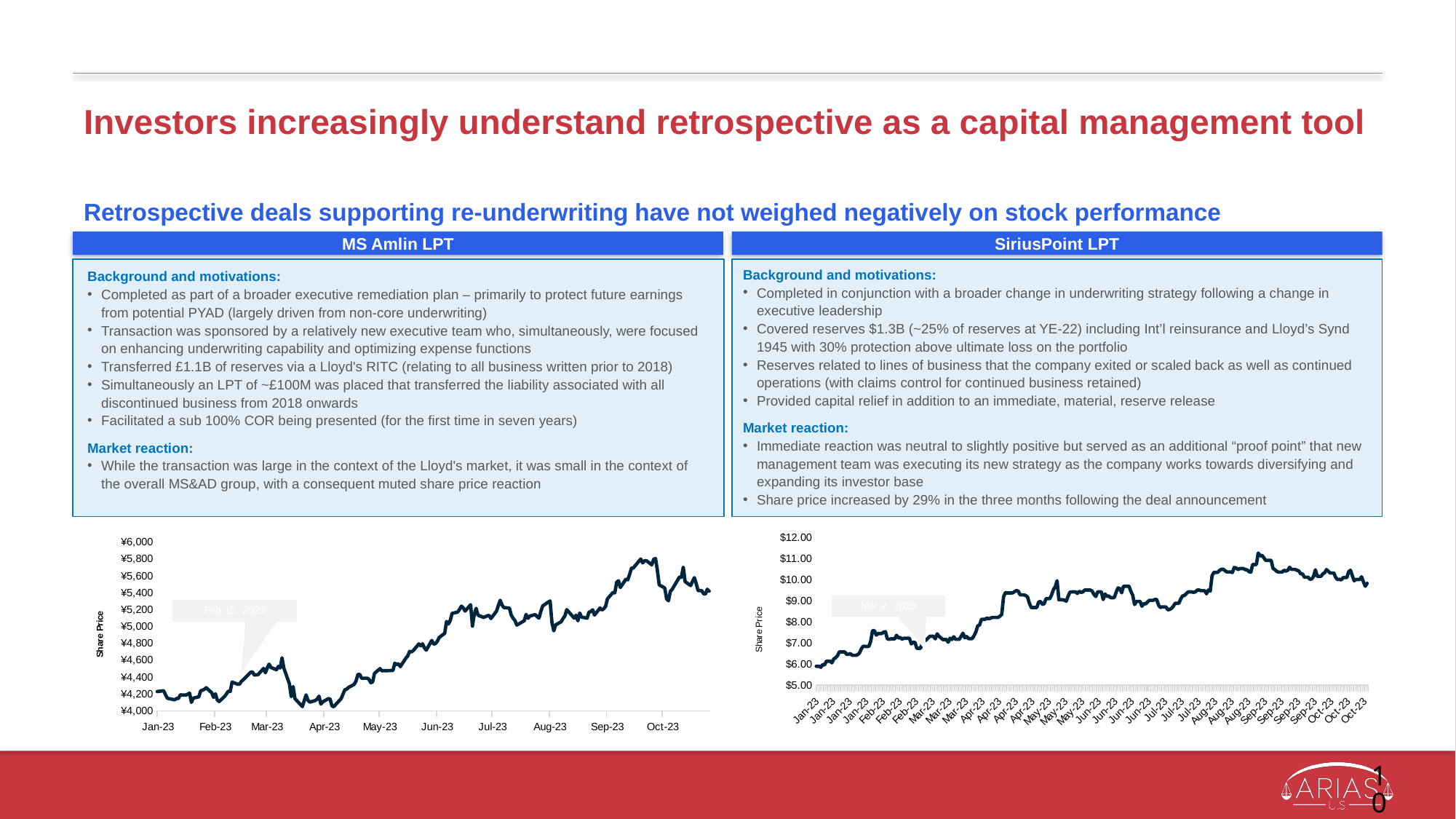
What kind of chart is the SiriusPoint LPT chart on the right? Line chart In the SiriusPoint LPT chart, does the share price overall rise or fall from Jan-23 to Oct-23? Rise In the SiriusPoint LPT chart, is the share price at the end of Oct-23 greater or less than $9.00? greater In the MS Amlin LPT chart, is the share price at the start of Apr-23 greater or less than ¥4,400? less In the MS Amlin LPT chart, does the share price overall rise or fall from Jan-23 to Oct-23? Rise What is the highest y-axis tick shown on the MS Amlin LPT chart? ¥6,000 In the SiriusPoint LPT chart, is the share price in Jan-23 greater or less than $8.00? less What is the y-axis label on the MS Amlin LPT chart? Share Price What kind of chart is the MS Amlin LPT chart on the left? Line chart